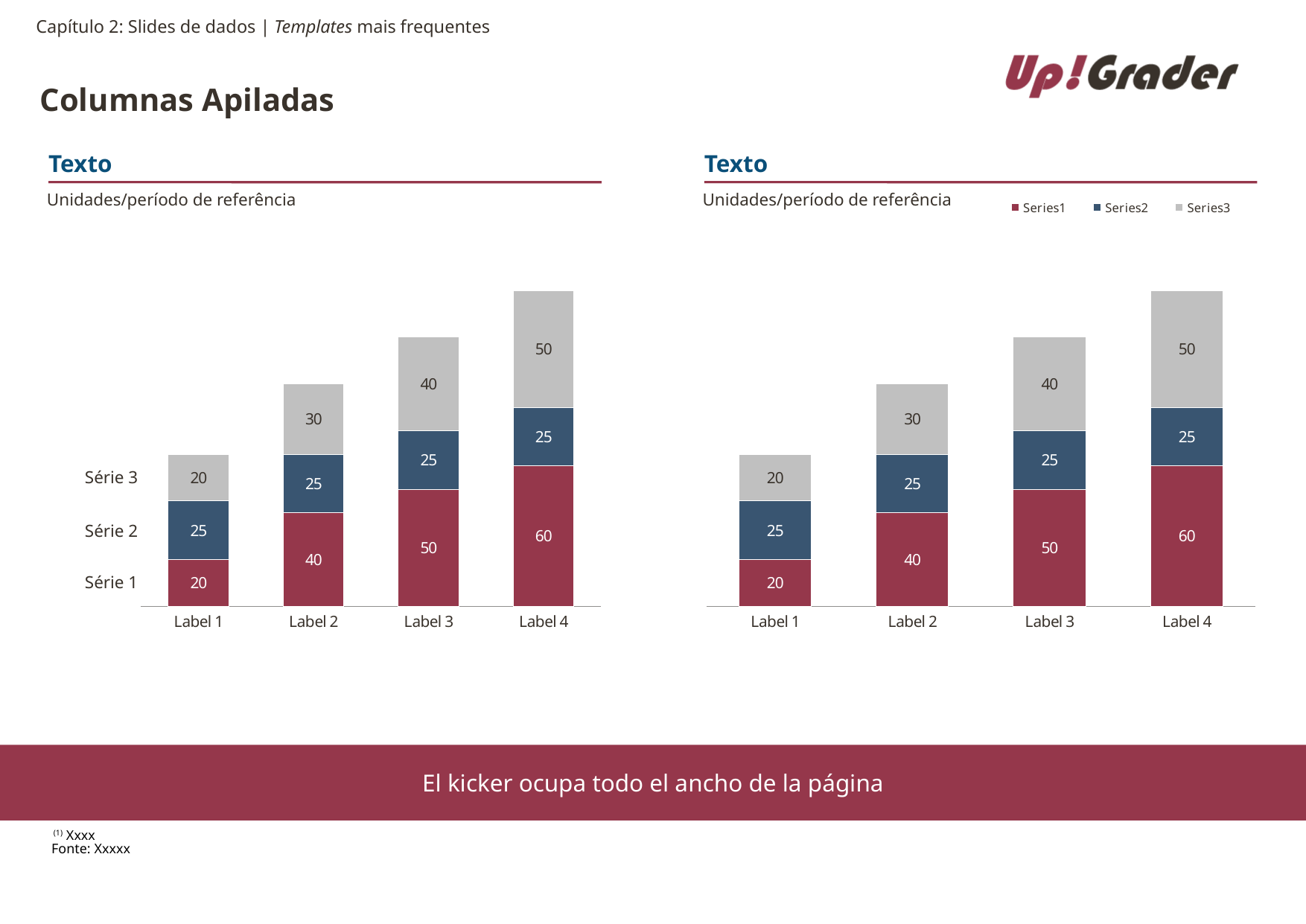
In the left chart, what is the total of the stacked bar for Label 1? 65 In the right chart, what is the difference between the Series1 values for Label 4 and Label 2? 20 In the left chart, what is the value of Série 1 for Label 3? 50 In the left chart, what is the value of Série 2 for Label 4? 25 How many series does the legend of the right chart list? 3 What type of chart is the left chart? Stacked bar chart In the left chart, is the Série 3 value for Label 4 larger or smaller than the Série 3 value for Label 2? larger In the right chart, what is the value of Series3 for Label 2? 30 In the right chart, what is the total of the stacked bar for Label 4? 135 In the right chart, which category has the highest Series1 value? Label 4 In the left chart, which category has the lowest Série 3 value? Label 1 How many categories are shown on the x axis of the right chart? 4